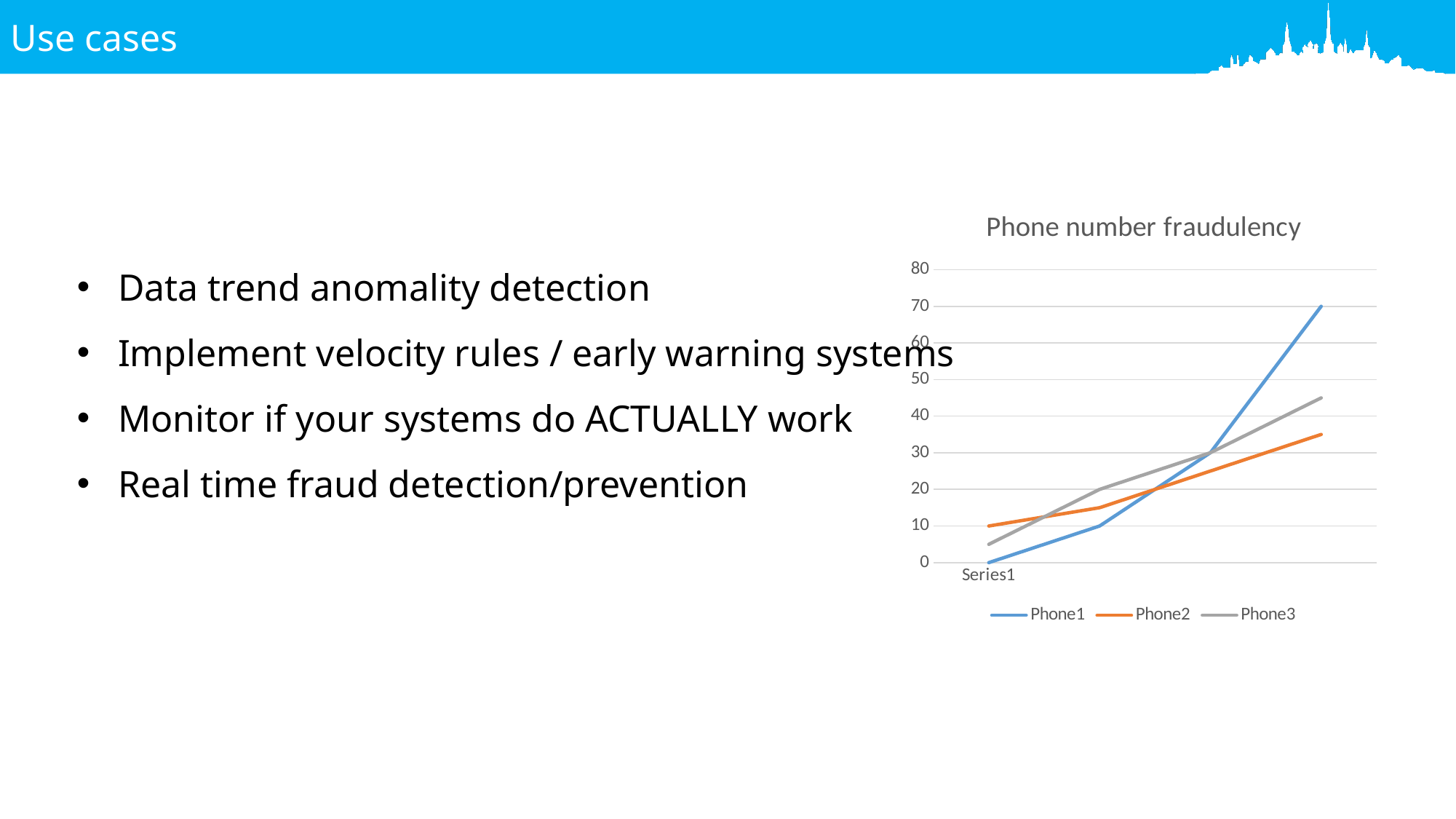
Which series reaches the highest value at the right end of the chart? Phone1 What kind of chart is shown on the slide? line chart Which series has the lowest value at the right end of the chart? Phone2 At the first point (Series1), which series has the lowest value? Phone1 Which series are listed in the chart legend? Phone1, Phone2, Phone3 Is the final value of Phone2 greater or less than 40? less How many series does the chart legend list? 3 At the right end of the chart, which is larger: Phone3 or Phone2? Phone3 Is the final value of Phone1 greater or less than 60? greater Does the Phone1 line rise or fall from left to right? rise Does the Phone2 line rise or fall from left to right? rise What is the title of the chart? Phone number fraudulency